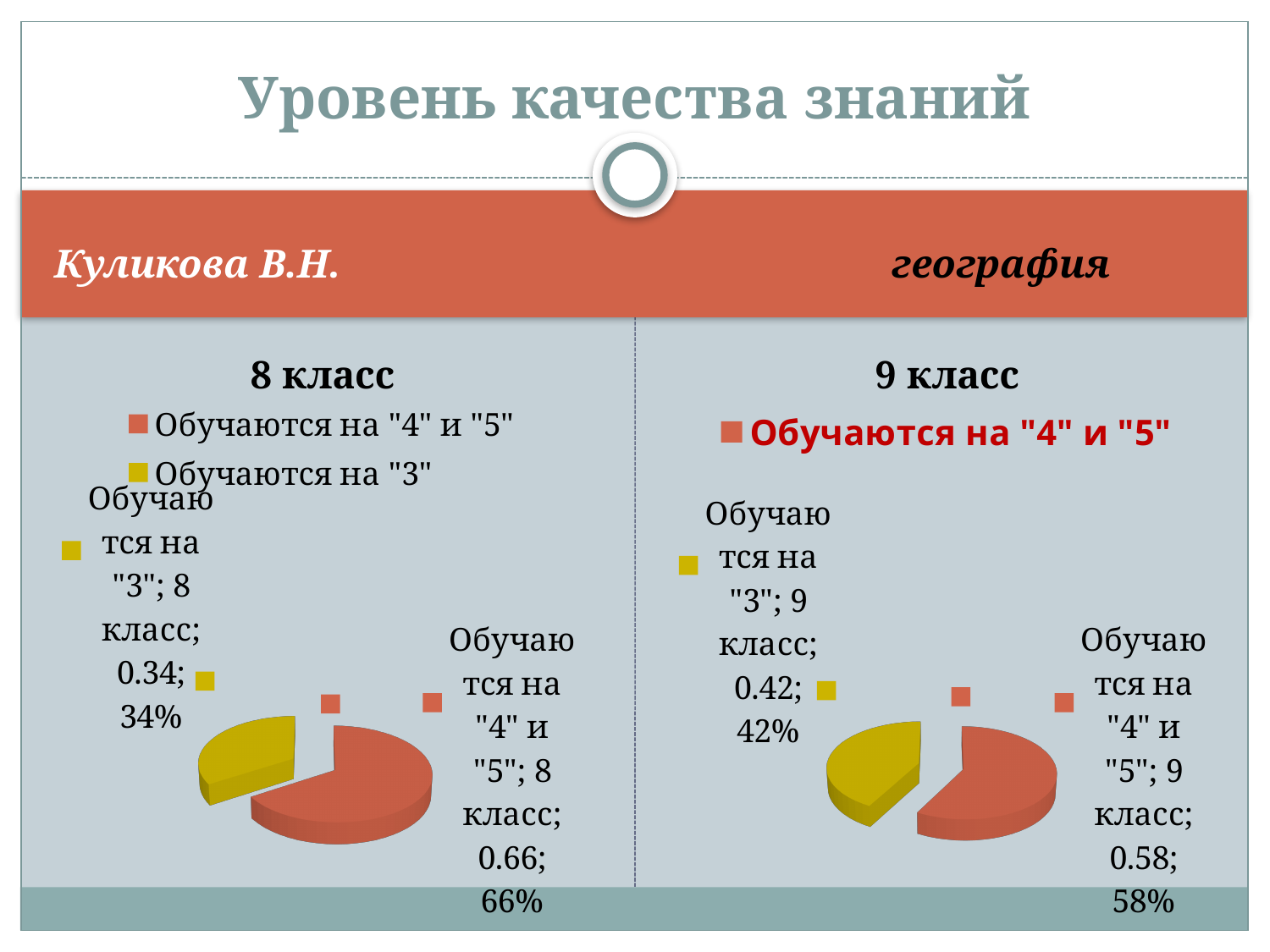
In the "8 класс" chart, what value is printed for "Обучаются на "4" и "5"" before the percentage? 0.66 In the "9 класс" chart, what share of the pie is "Обучаются на "3""? 42% In the "8 класс" chart, what share of the pie is "Обучаются на "3""? 34% In the "9 класс" chart, which slice is the smallest? Обучаются на "3" How many slices does the "9 класс" chart have? 2 In the "9 класс" chart, what value is printed for "Обучаются на "3"" before the percentage? 0.42 In the "8 класс" chart, what is the difference in percentage points between the "4" и "5" slice and the "3" slice? 32 In the "8 класс" chart, which slice is the largest? Обучаются на "4" и "5" In the "8 класс" chart, what share of the pie is "Обучаются на "4" и "5""? 66% What type of chart is used for "8 класс"? Pie chart Which chart has the larger share for "Обучаются на "4" и "5"": "8 класс" or "9 класс"? 8 класс